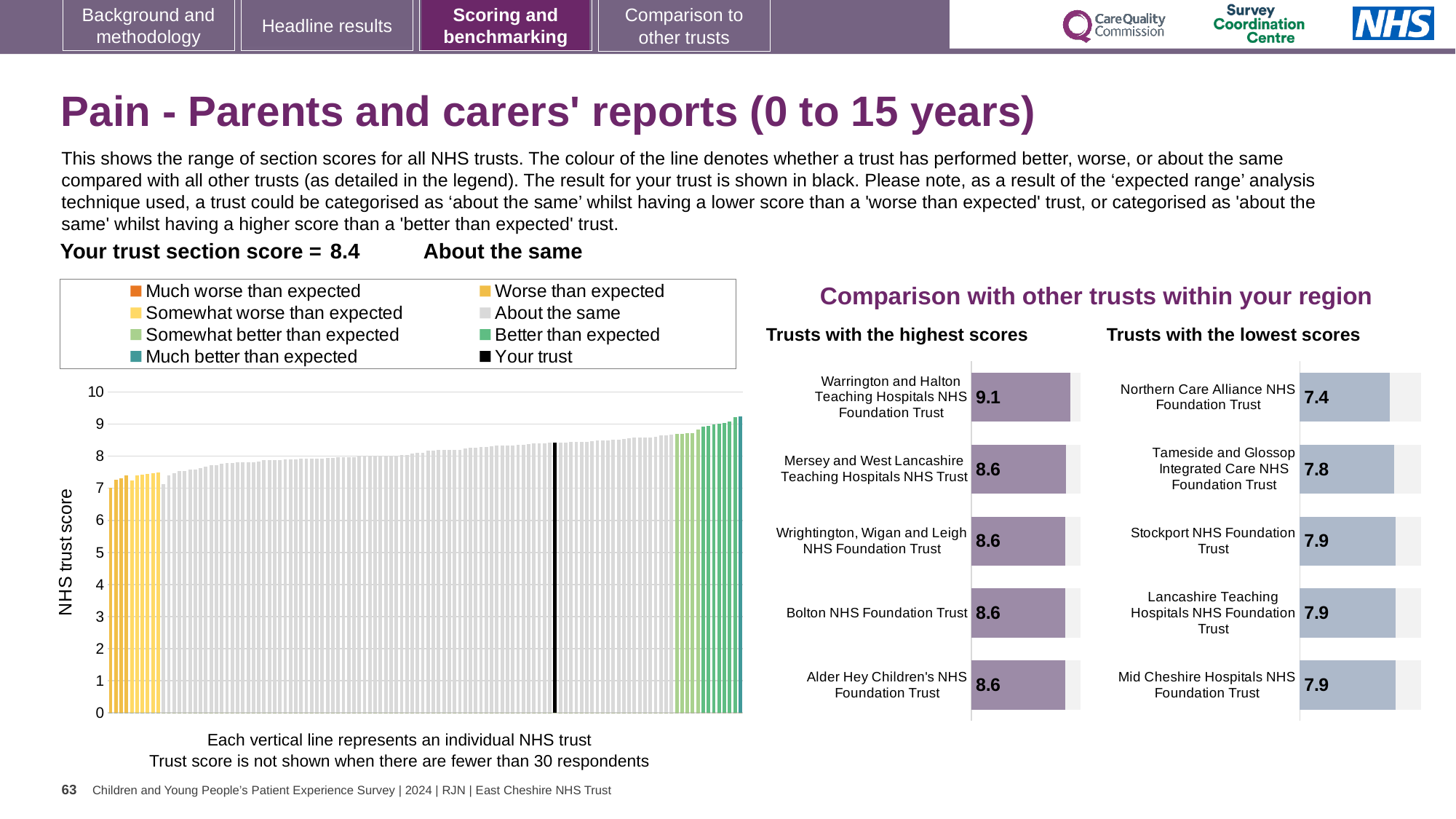
In the 'Trusts with the lowest scores' chart, which has the larger score: Stockport NHS Foundation Trust or Northern Care Alliance NHS Foundation Trust? Stockport NHS Foundation Trust In the 'Trusts with the lowest scores' chart, what is the score for Northern Care Alliance NHS Foundation Trust? 7.4 In the 'Trusts with the lowest scores' chart, which trust has the lowest score? Northern Care Alliance NHS Foundation Trust How many trusts are shown in the 'Trusts with the highest scores' chart? 5 In the 'Trusts with the lowest scores' chart, what is the score for Tameside and Glossop Integrated Care NHS Foundation Trust? 7.8 In the main chart on the left showing all NHS trusts, what is the section score for your trust (the black line)? 8.4 In the 'Trusts with the highest scores' chart, what is the difference between the scores of Warrington and Halton Teaching Hospitals NHS Foundation Trust and Bolton NHS Foundation Trust? 0.5 In the 'Trusts with the highest scores' chart, what is the score for Warrington and Halton Teaching Hospitals NHS Foundation Trust? 9.1 How many entries does the legend of the main chart on the left list? 8 What is the difference between the score for Warrington and Halton Teaching Hospitals NHS Foundation Trust in the highest scores chart and the score for Northern Care Alliance NHS Foundation Trust in the lowest scores chart? 1.7 In the main chart on the left showing all NHS trusts, do the trust scores rise or fall from left to right? rise In the 'Trusts with the highest scores' chart, which trust has the highest score? Warrington and Halton Teaching Hospitals NHS Foundation Trust